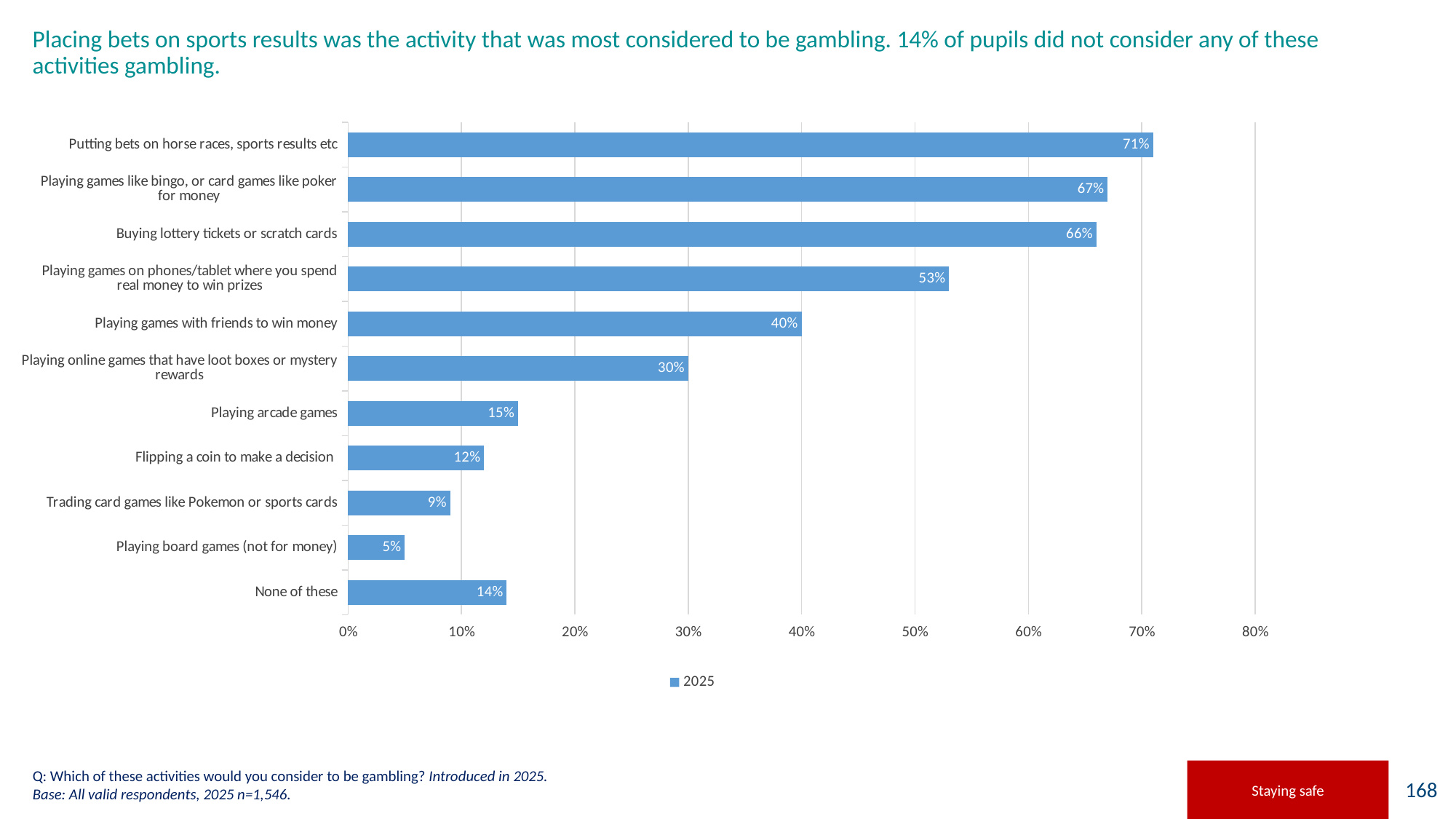
What is the difference between the values for 'Buying lottery tickets or scratch cards' and 'Playing games with friends to win money'? 26% Which activity has the lowest percentage? Playing board games (not for money) Which is larger: the value for 'Playing arcade games' or the value for 'Flipping a coin to make a decision'? Playing arcade games What is the value for 'Playing online games that have loot boxes or mystery rewards'? 30% How many categories (bars) are shown in the chart? 11 What percentage of pupils considered putting bets on horse races, sports results etc to be gambling? 71% What is the legend entry shown below the chart? 2025 Is the value for 'Playing games on phones/tablet where you spend real money to win prizes' greater or less than 50%? greater What percentage of pupils selected 'None of these'? 14% How many series does the legend list? 1 Which activity has the highest percentage of pupils considering it gambling? Putting bets on horse races, sports results etc What kind of chart is shown on the slide? Bar chart